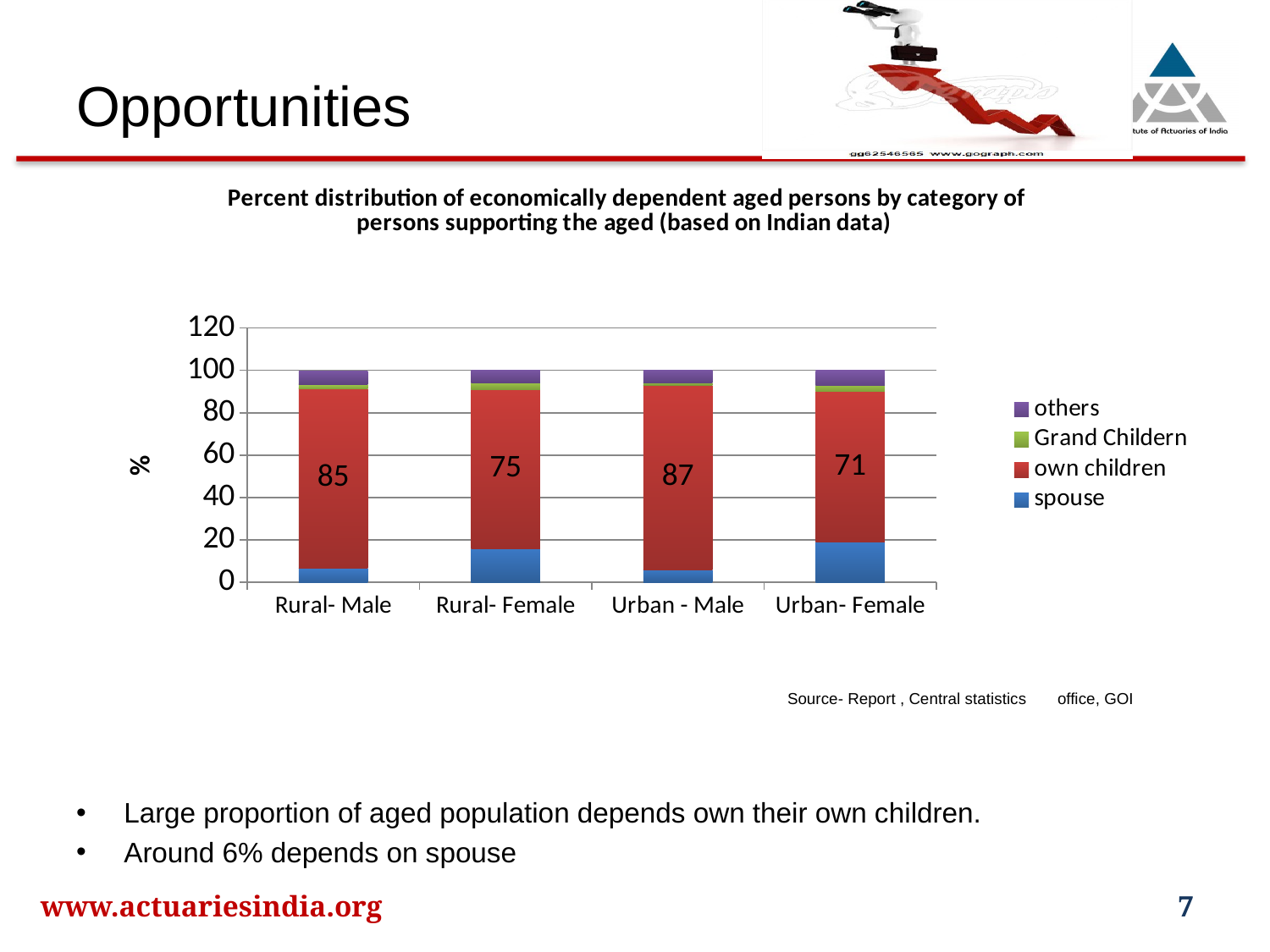
What kind of chart is shown on the slide? stacked bar chart What label is shown on the y axis of the chart? % What is the value for own children for Rural- Male? 85 Which category has the lowest value for own children? Urban- Female What is the value for own children for Rural- Female? 75 What is the value for own children for Urban- Female? 71 Is the spouse value for Rural- Male greater or less than 20? less Which category has the highest value for own children? Urban - Male How many series does the legend list? 4 What is the difference between the own children values for Urban - Male and Urban- Female? 16 Which is larger, the own children value for Rural- Male or for Rural- Female? Rural- Male How many categories are shown on the x axis? 4